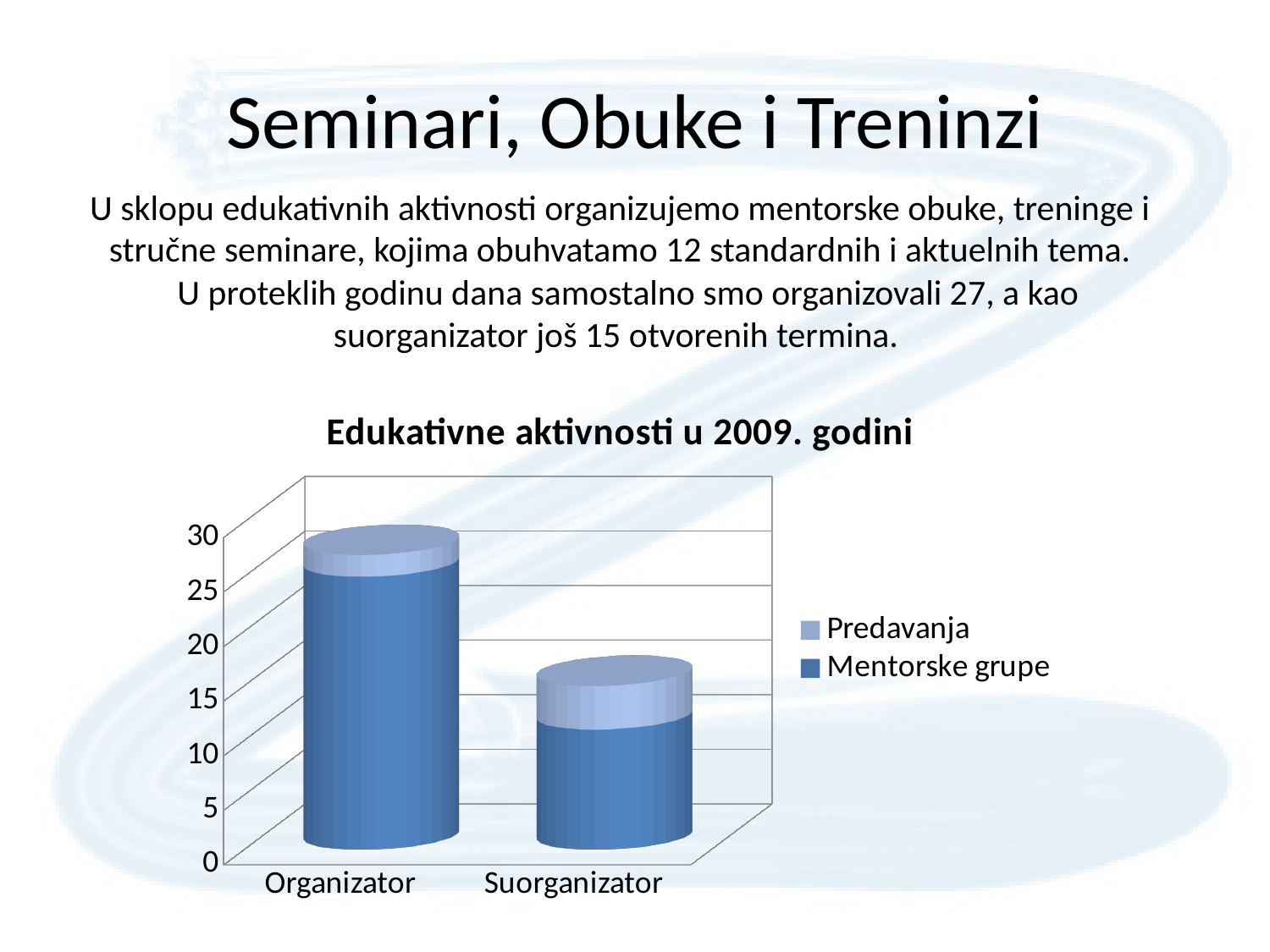
Is the total stacked value for Suorganizator greater or less than 20? less How many series does the chart legend list? 2 Is the Mentorske grupe value for Organizator greater or less than 20? greater Which category has the lowest total in the chart? Suorganizator What type of chart is shown on the slide? bar chart Is the total stacked value for Organizator greater or less than 20? greater Which category has the highest total in the chart? Organizator How many categories are shown on the x axis of the chart? 2 Which category has the taller stacked bar, Organizator or Suorganizator? Organizator Which series is shown in the lighter blue colour in the chart? Predavanja What is the title of the chart? Edukativne aktivnosti u 2009. godini